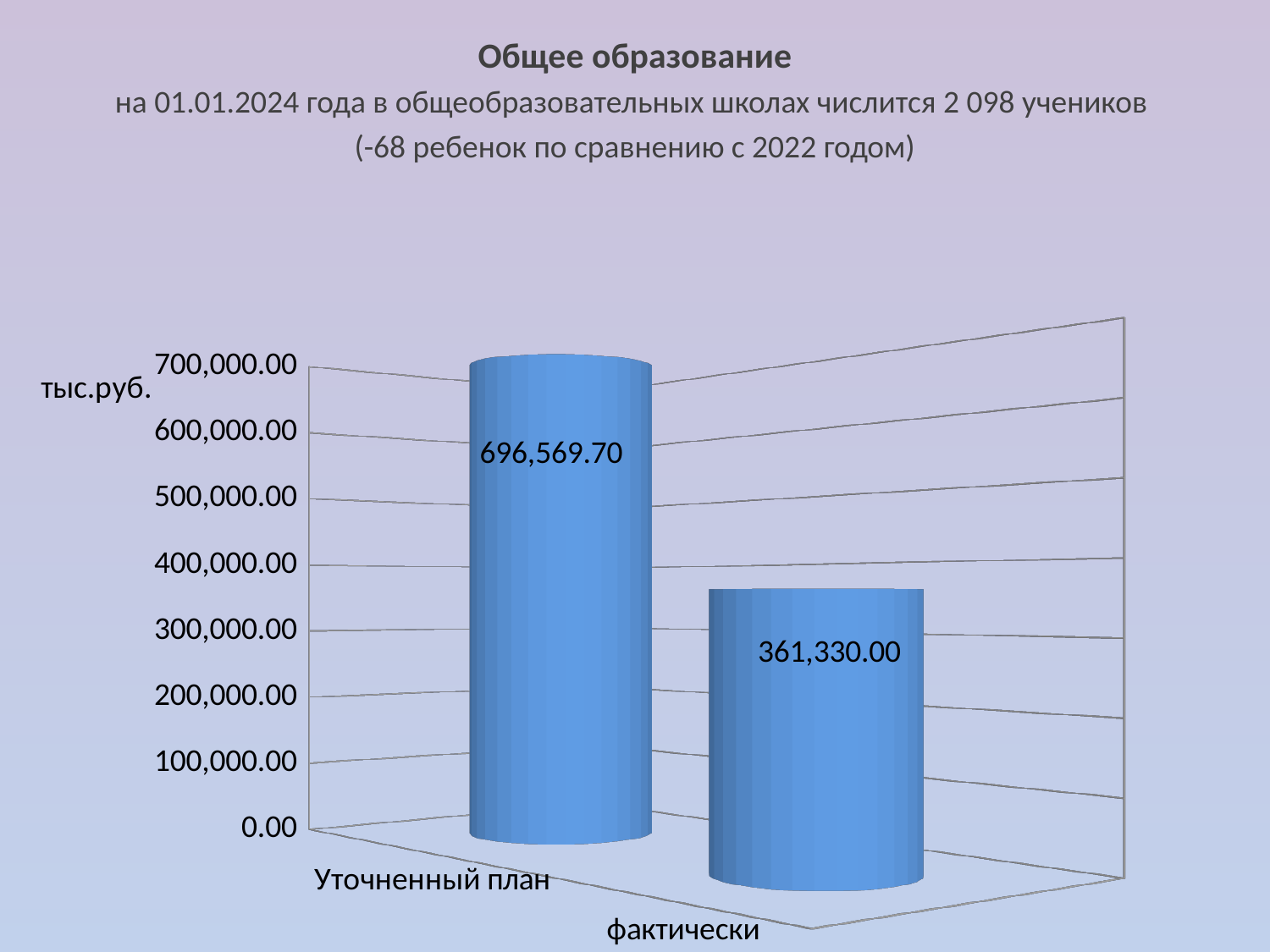
Is the value for фактически greater or less than 400,000.00? less How many categories are shown on the chart? 2 What is the title of the slide? Общее образование What kind of chart is shown on the slide? bar chart Which category has the highest value? Уточненный план Which is larger, the value for Уточненный план or the value for фактически? Уточненный план Is the value for Уточненный план greater or less than 600,000.00? greater What is the difference between the value for Уточненный план and the value for фактически? 335,239.70 What unit is shown on the vertical axis of the chart? тыс.руб. What is the value for Уточненный план? 696,569.70 Which category has the lowest value? фактически What is the value for фактически? 361,330.00